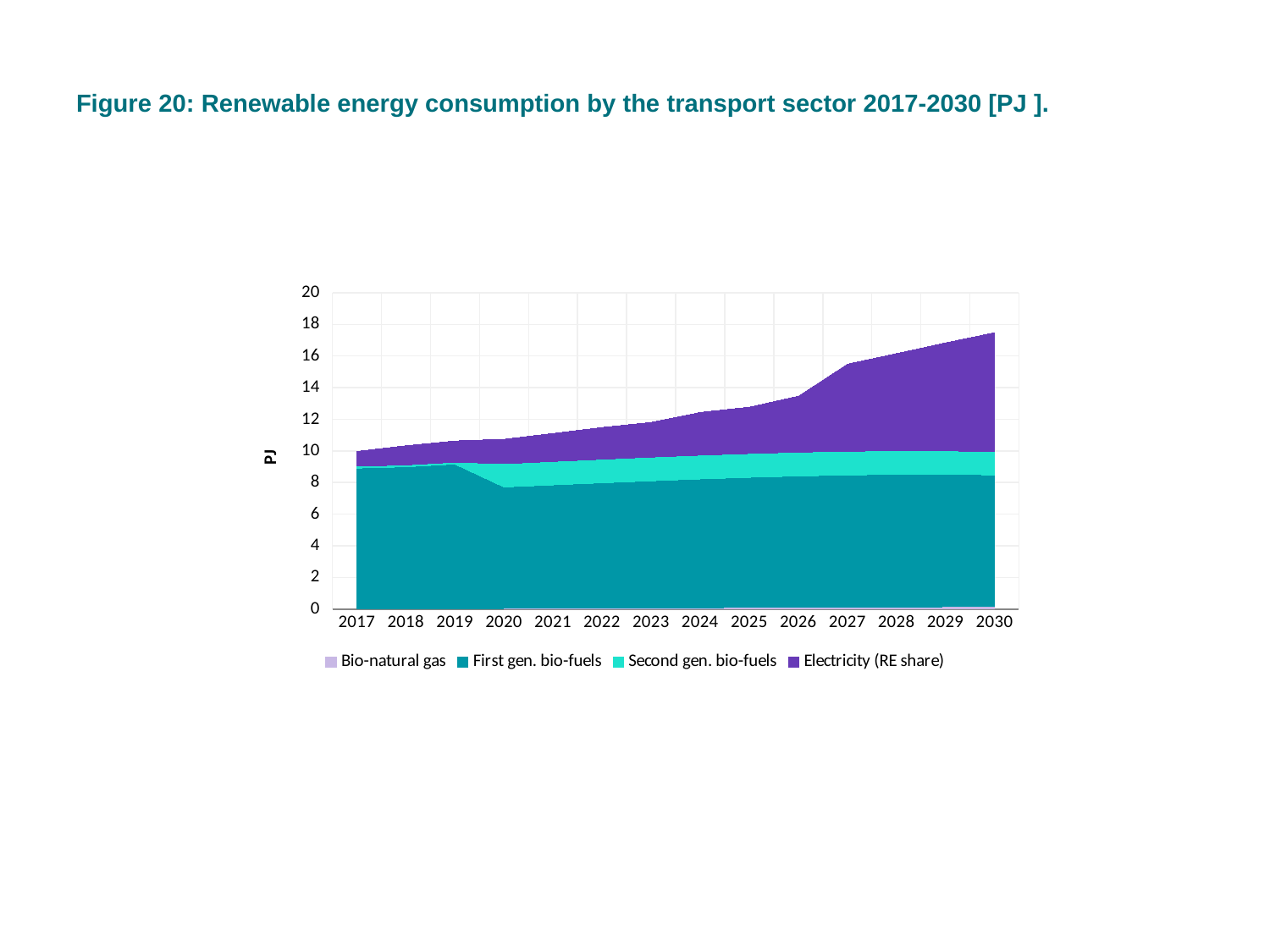
What kind of chart is shown on the slide? Stacked area chart Which year has the highest total renewable energy consumption? 2030 How many years are shown along the x axis? 14 Is the total renewable energy consumption in 2020 greater or less than 12 PJ? less Does total renewable energy consumption rise or fall from 2017 to 2030? Rise Which year has the lowest total renewable energy consumption? 2017 Is the total renewable energy consumption in 2030 greater or less than 16 PJ? greater Is the total renewable energy consumption in 2017 greater or less than 12 PJ? less Which year has the larger total renewable energy consumption, 2017 or 2030? 2030 How many series does the legend list? 4 What is the label on the y axis? PJ